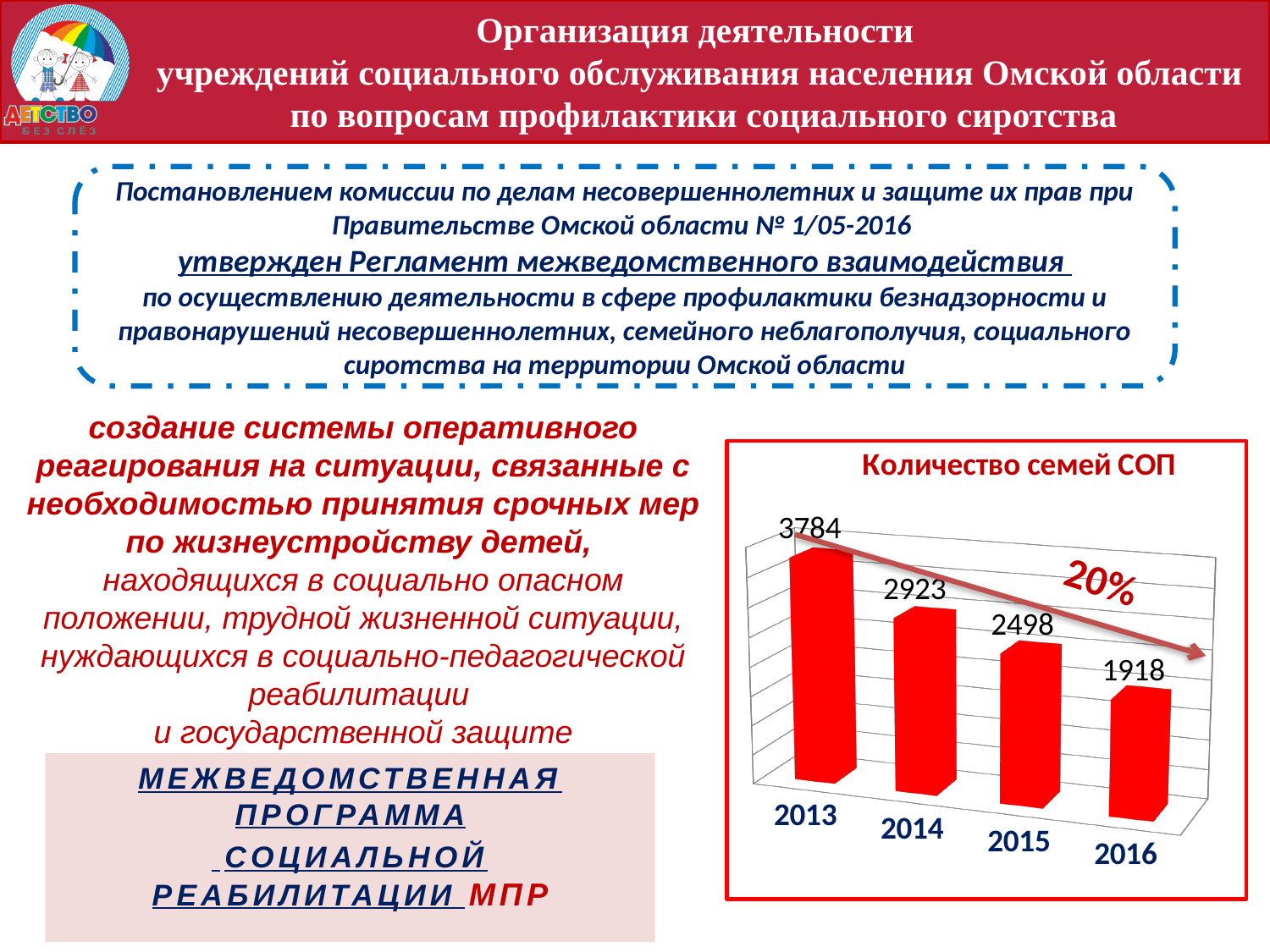
Which is larger in the chart 'Количество семей СОП': the value for 2014 or the value for 2016? 2014 What kind of chart is 'Количество семей СОП'? bar chart What is the difference between the values for 2014 and 2015 in the chart 'Количество семей СОП'? 425 What is the value for 2015 in the chart 'Количество семей СОП'? 2498 How many years are shown in the chart 'Количество семей СОП'? 4 What is the value for 2014 in the chart 'Количество семей СОП'? 2923 Do the values in the chart 'Количество семей СОП' rise or fall from 2013 to 2016? fall Which year has the lowest value in the chart 'Количество семей СОП'? 2016 What is the value for 2013 in the chart 'Количество семей СОП'? 3784 Which year has the highest value in the chart 'Количество семей СОП'? 2013 What is the difference between the values for 2013 and 2016 in the chart 'Количество семей СОП'? 1866 What is the value for 2016 in the chart 'Количество семей СОП'? 1918